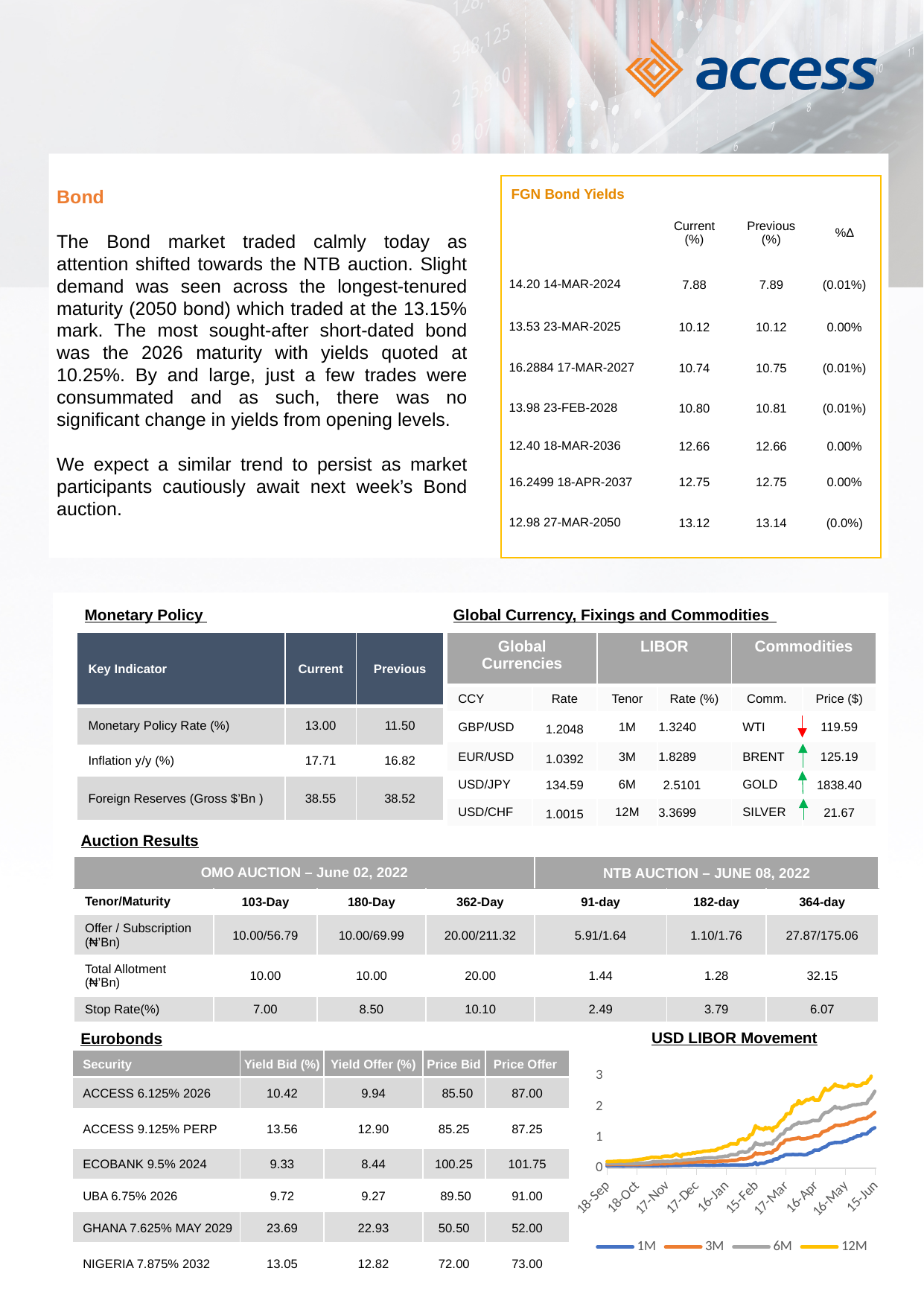
In the USD LIBOR Movement chart, which is larger at 15-Jun: the 6M value or the 3M value? 6M In the USD LIBOR Movement chart, which series has the lowest value at 15-Jun? 1M In the USD LIBOR Movement chart, do the values rise or fall from 18-Sep to 15-Jun? rise How many series does the legend of the USD LIBOR Movement chart list? 4 In the USD LIBOR Movement chart, is the 1M value at 18-Sep greater or less than 1? less How many date labels are shown on the x axis of the USD LIBOR Movement chart? 10 What kind of chart is the USD LIBOR Movement chart? line chart In the USD LIBOR Movement chart, which series has the highest value at 15-Jun? 12M In the USD LIBOR Movement chart, is the 1M value at 15-Jun greater or less than 1? greater In the USD LIBOR Movement chart, is the 12M value at 15-Jun greater or less than 2? greater What colour is the 12M line in the USD LIBOR Movement chart? yellow Which series are listed in the legend of the USD LIBOR Movement chart? 1M, 3M, 6M, 12M